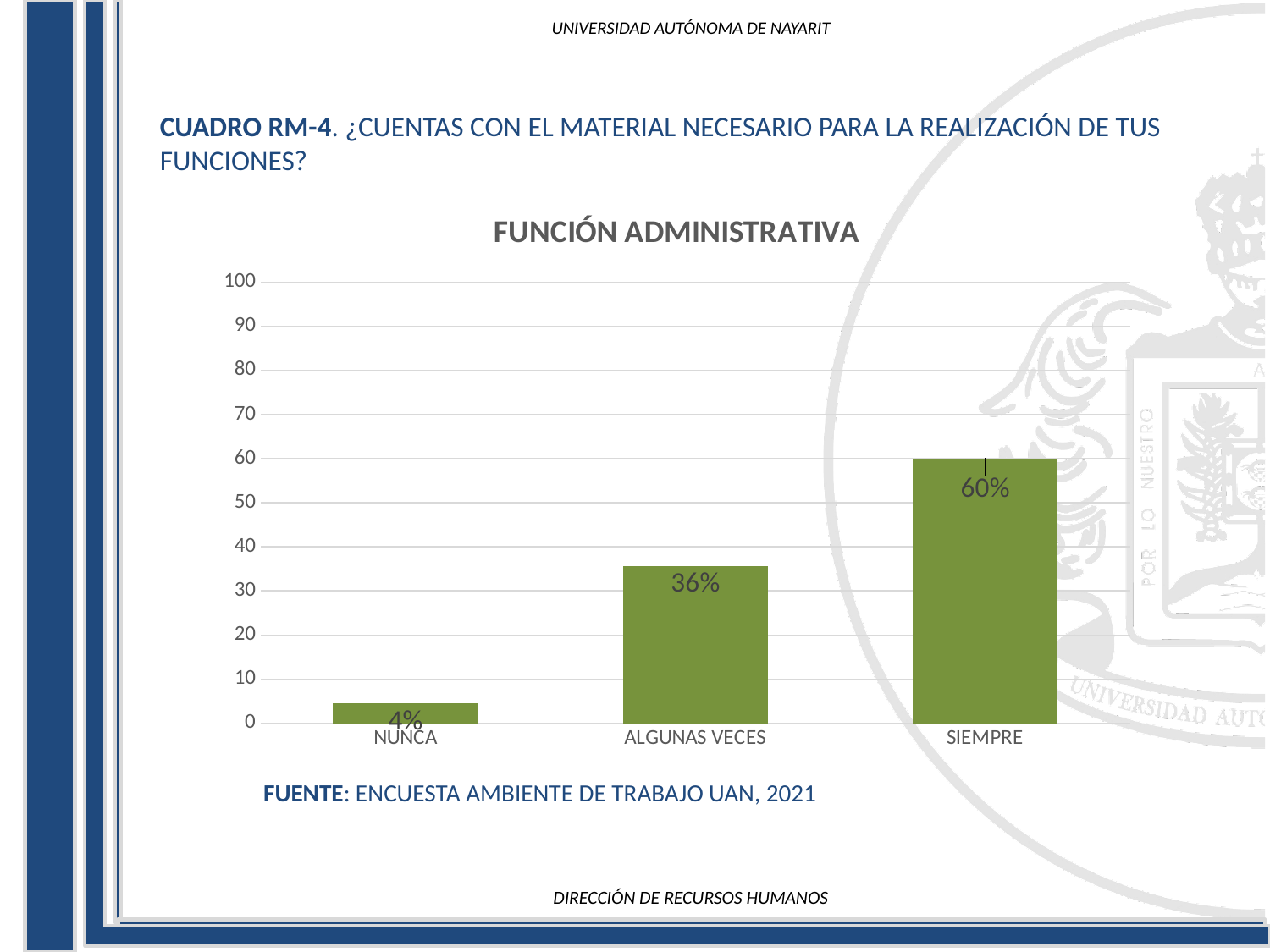
Which is larger, the value for ALGUNAS VECES or the value for NUNCA? ALGUNAS VECES Is the value for SIEMPRE greater or less than 50? greater What kind of chart is shown? bar chart What is the difference between the values for ALGUNAS VECES and NUNCA? 32% How many categories are shown on the x axis? 3 What is the value for NUNCA? 4% Which category has the lowest value? NUNCA Which category has the highest value? SIEMPRE What is the value for SIEMPRE? 60% What is the difference between the values for SIEMPRE and ALGUNAS VECES? 24% What is the title of the chart? FUNCIÓN ADMINISTRATIVA What is the value for ALGUNAS VECES? 36%